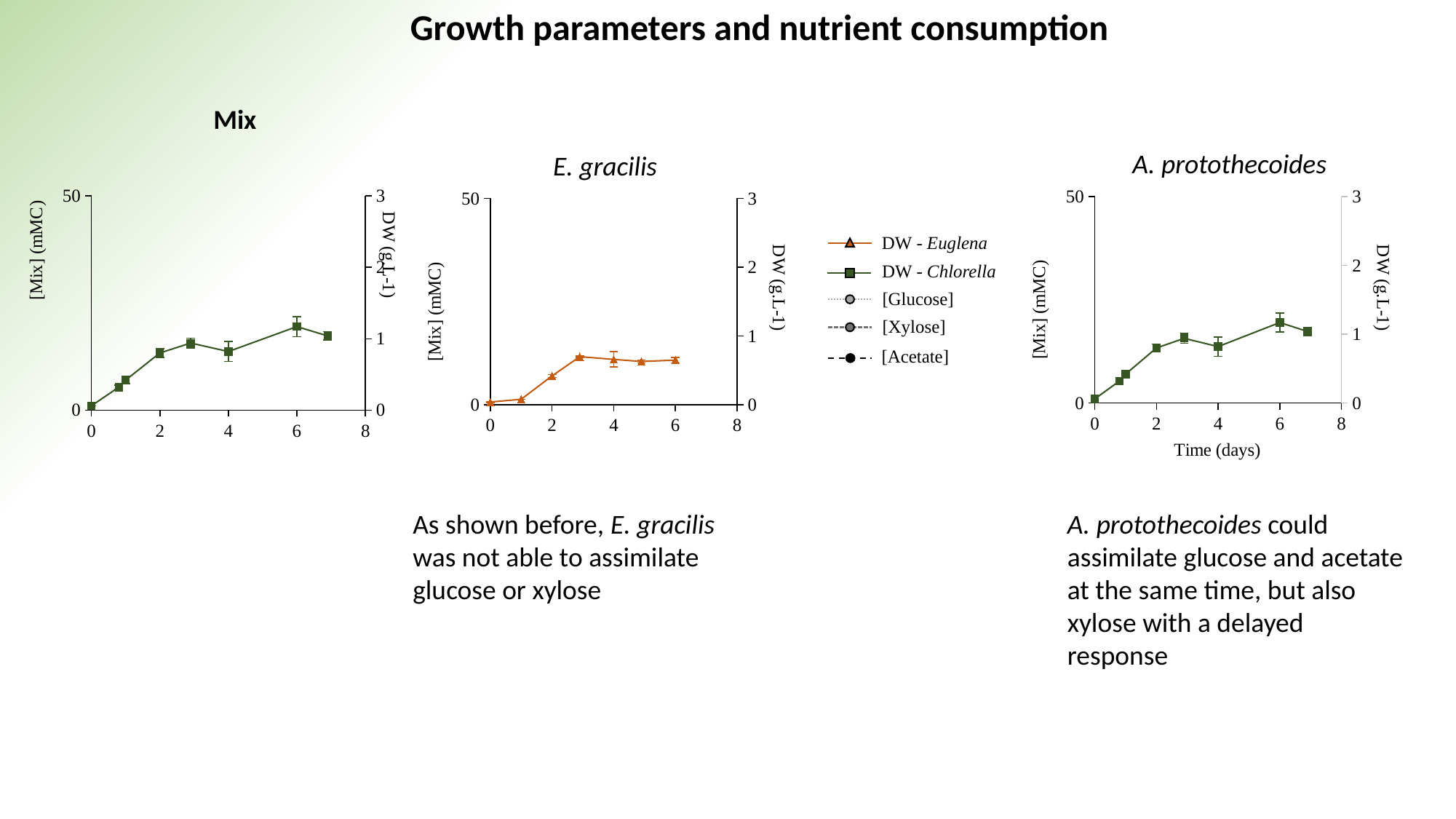
What is the x-axis label of the A. protothecoides chart? Time (days) In the E. gracilis chart, is the DW value at day 3 greater or less than 2? less In the A. protothecoides chart, does the DW value rise or fall between day 0 and day 2? rise In the Mix chart on the left, is the DW value at day 6 greater or less than 1? greater In the E. gracilis chart, how many data points are plotted? 7 In the A. protothecoides chart, is the DW value at day 6 greater or less than 1? greater How many entries does the legend in the middle of the slide list? 5 In the E. gracilis chart, does the DW value rise or fall between day 0 and day 3? rise In the A. protothecoides chart, which is larger, the DW value at day 4 or at day 6? day 6 What is the maximum value shown on the right-hand DW (g.L-1) axis of the A. protothecoides chart? 3 What kind of chart is the E. gracilis chart? line chart